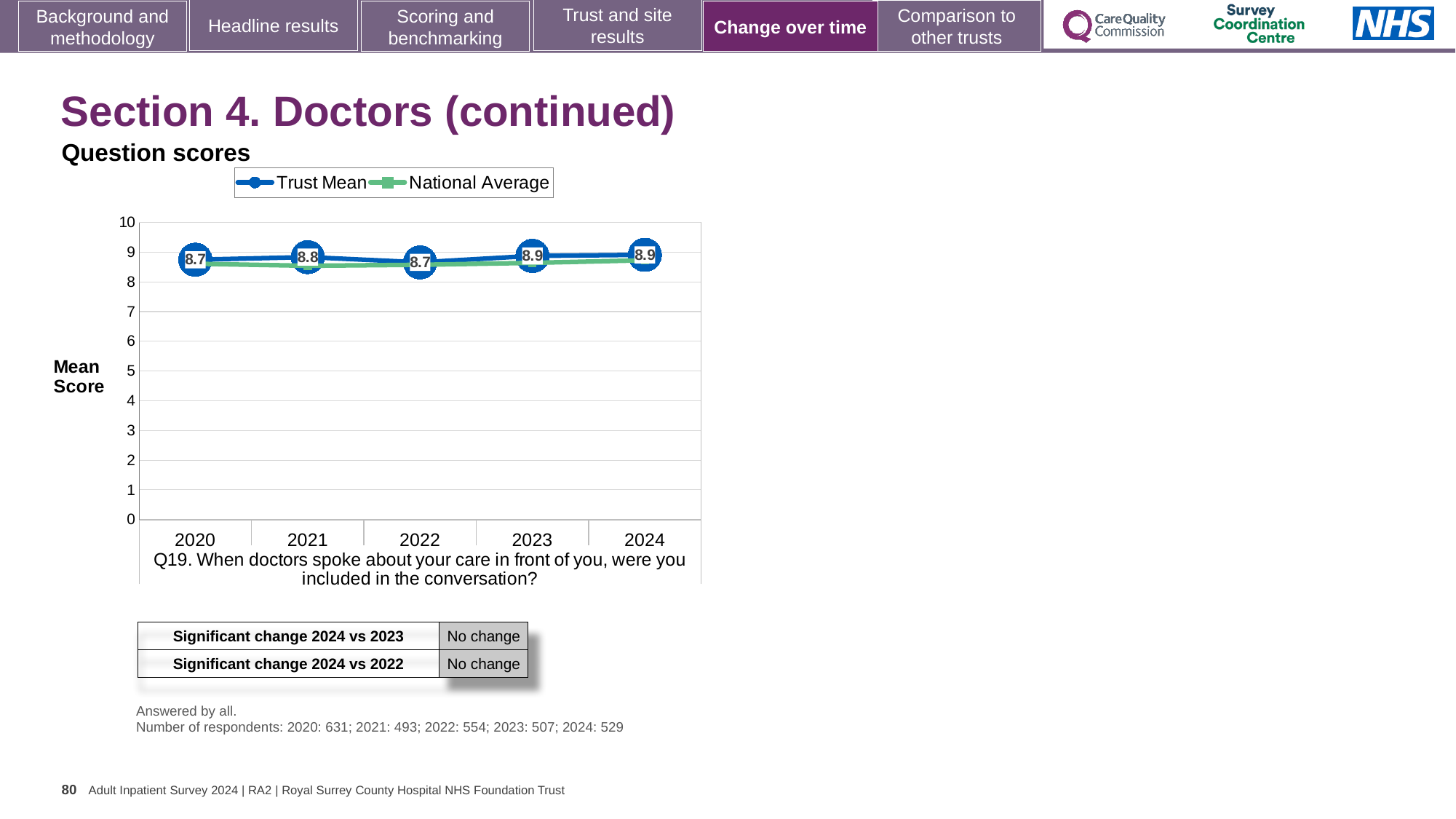
How many years are plotted on the x axis? 5 Which year has the larger Trust Mean, 2021 or 2022? 2021 What are the two series named in the legend? Trust Mean and National Average How many series does the legend list? 2 Is the National Average value for 2022 greater or less than 5? greater What is the Trust Mean value for 2023? 8.9 What is the difference between the Trust Mean in 2024 and in 2020? 0.2 What is the label on the y axis of the chart? Mean Score What is the Trust Mean value for 2020? 8.7 Does the Trust Mean rise or fall overall from 2020 to 2024? rise What kind of chart is shown on the slide? line chart What is the Trust Mean value for 2021? 8.8